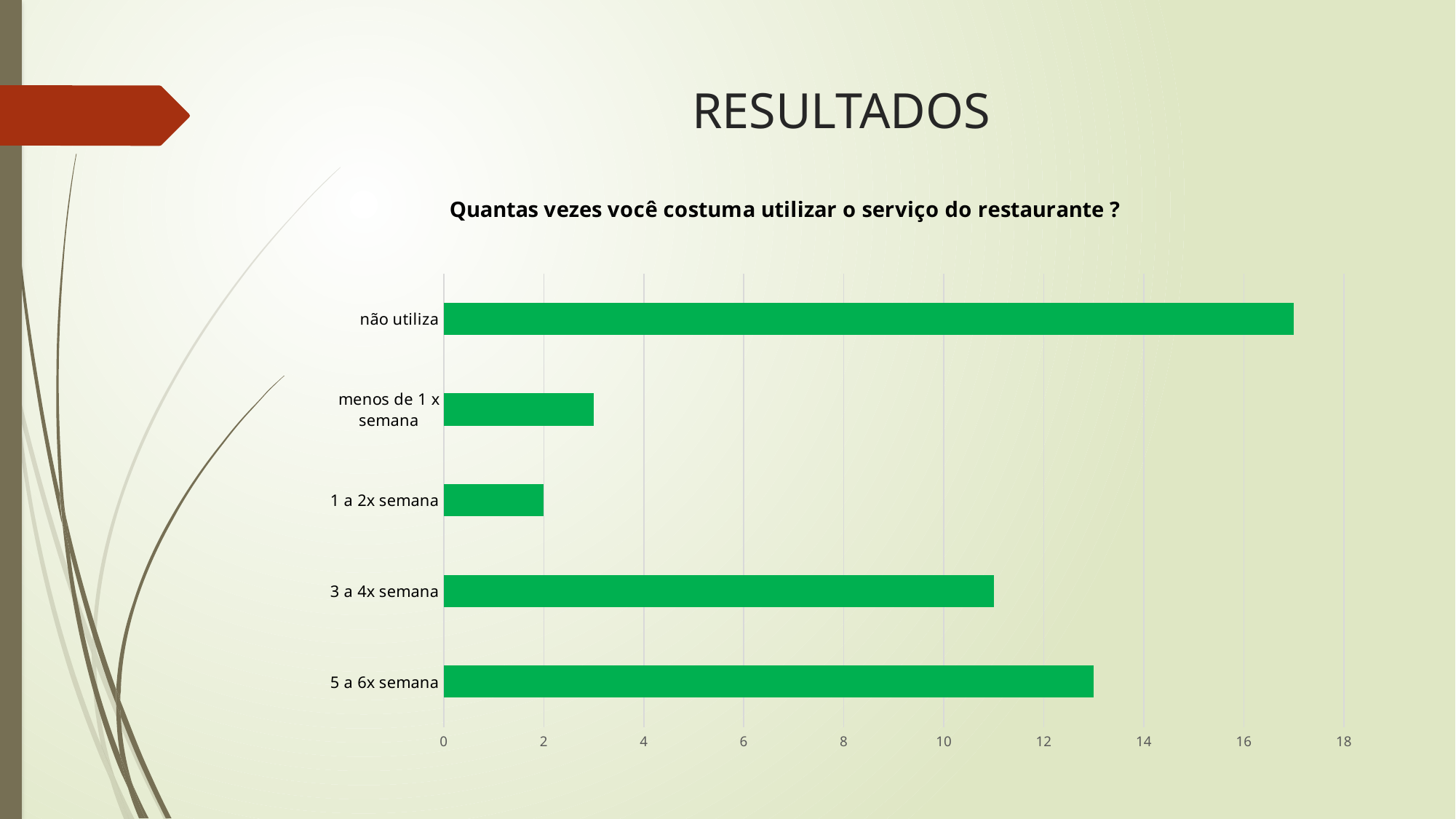
What colour are the bars in the chart? green Is the value for "não utiliza" greater or less than 16? greater What is the value for "1 a 2x semana"? 2 Which category has the lowest value? 1 a 2x semana Is the value for "3 a 4x semana" greater or less than 10? greater What kind of chart is shown on the slide? bar chart Which category has the highest value? não utiliza Which is larger, the value for "5 a 6x semana" or the value for "3 a 4x semana"? 5 a 6x semana How many categories are shown in the chart? 5 Is the value for "5 a 6x semana" greater or less than 14? less What is the title of the chart? Quantas vezes você costuma utilizar o serviço do restaurante ?